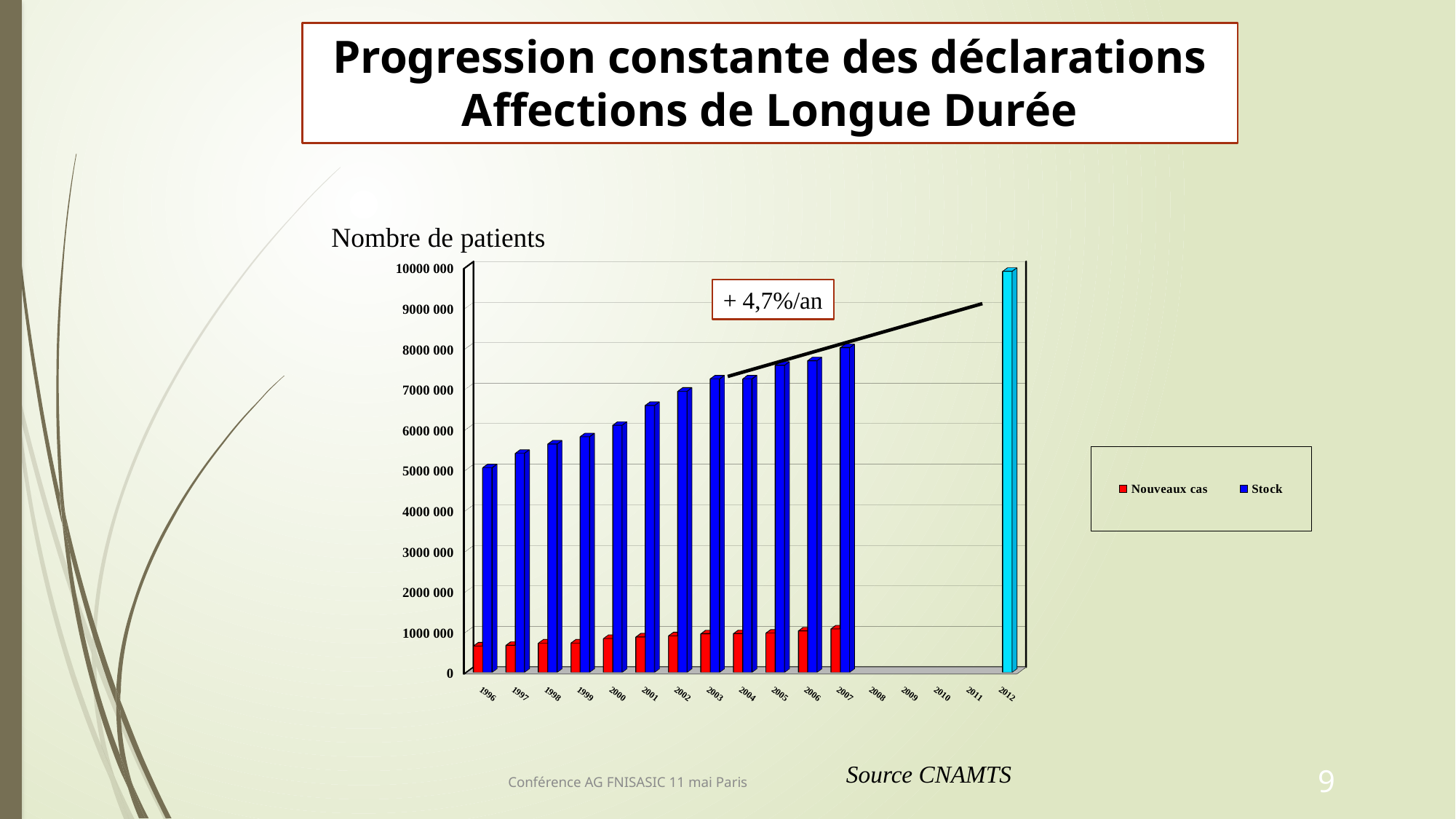
Is the Stock value for 2001 greater or less than 6000 000? greater Which year has the highest Stock value among the blue bars (1996–2007)? 2007 Does the Stock series rise or fall from 1996 to 2007? rise Is the Nouveaux cas value for 1996 greater or less than 1000 000? less Is the value of the bar for 2012 greater or less than 9000 000? greater How many series does the legend list? 2 What kind of chart is shown on the slide? bar chart What are the two series named in the legend? Nouveaux cas and Stock What annual growth rate is annotated on the chart? + 4,7%/an Which is larger, the Stock value for 2005 or for 2004? 2005 Which year has the lowest Stock value among the blue bars? 1996 How many year labels are shown along the x axis? 17